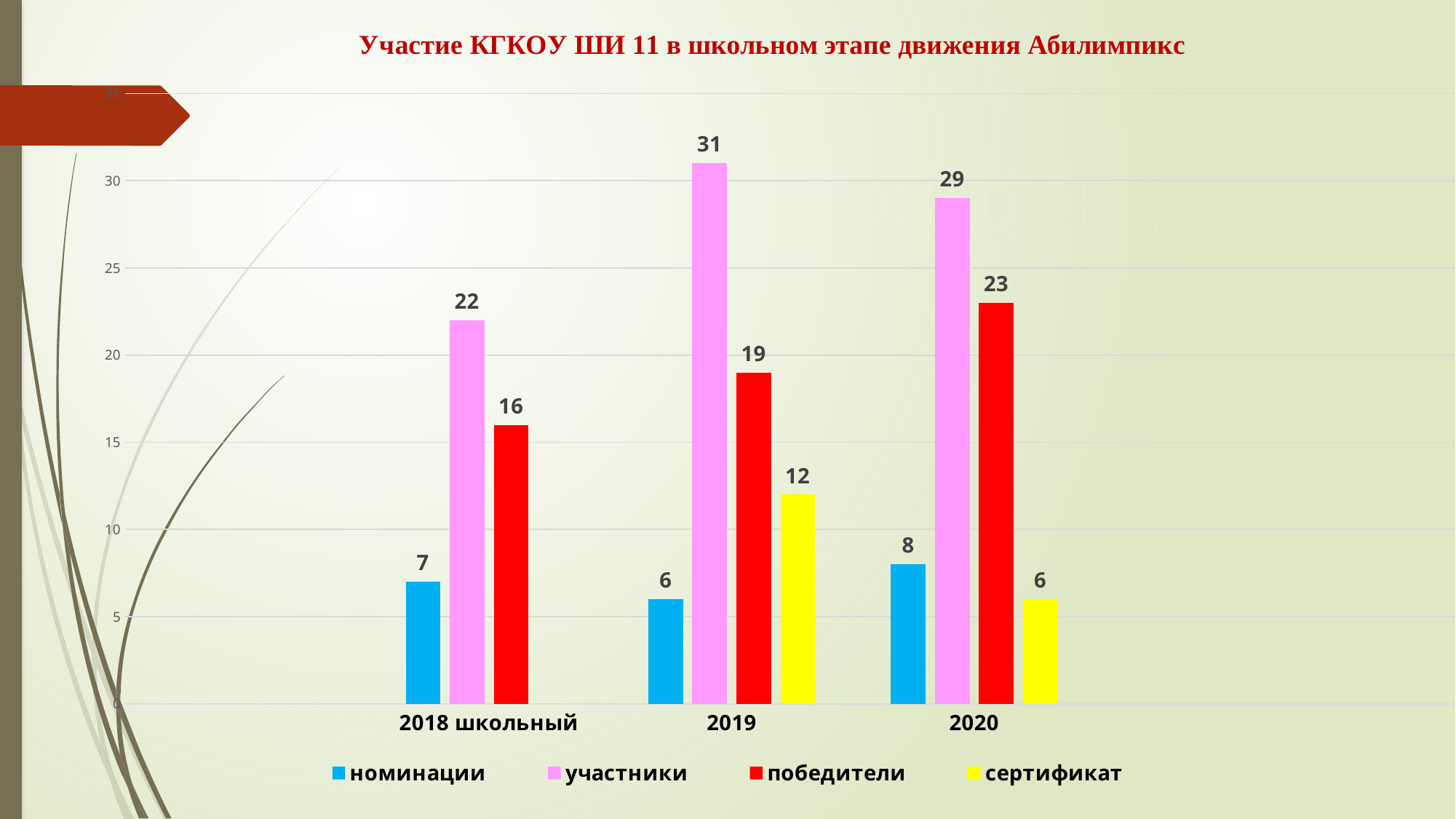
Does the value for победители rise or fall from 2018 школьный to 2020? rise What is the value for номинации in 2020? 8 What is the value for победители in 2018 школьный? 16 How many categories are shown on the x axis? 3 In which year is the value for номинации lowest? 2019 Which is larger: победители in 2019 or победители in 2020? победители in 2020 In which year is the value for участники highest? 2019 What kind of chart is shown on the slide? bar chart What is the value for участники in 2019? 31 What is the difference between участники and победители in 2020? 6 What is the value for сертификат in 2020? 6 How many series does the legend list? 4